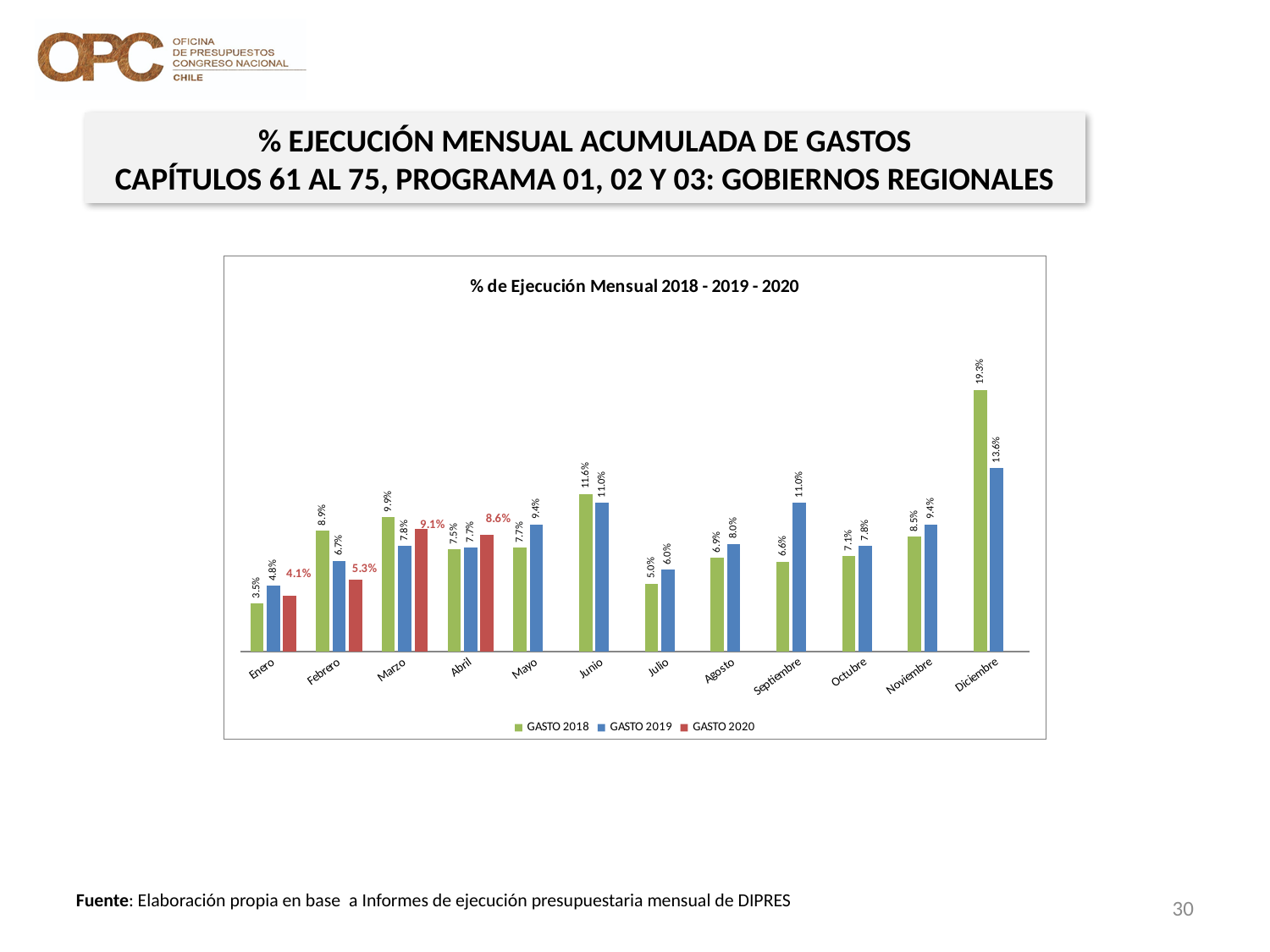
Which month has the lowest GASTO 2018 value? Enero What is the title of the chart? % de Ejecución Mensual 2018 - 2019 - 2020 Which month has the highest GASTO 2019 value? Diciembre What is the GASTO 2018 value for Diciembre? 19.3% What is the GASTO 2020 value for Abril? 8.6% Do the GASTO 2020 values rise or fall from Enero to Abril? Rise What is the GASTO 2019 value for Septiembre? 11.0% What is the difference between the GASTO 2018 and GASTO 2019 values for Diciembre? 5.7% What kind of chart is shown on the slide? Bar chart How many months are shown on the x axis? 12 How many series does the legend list? 3 Which is larger for Marzo, GASTO 2018 or GASTO 2020? GASTO 2018